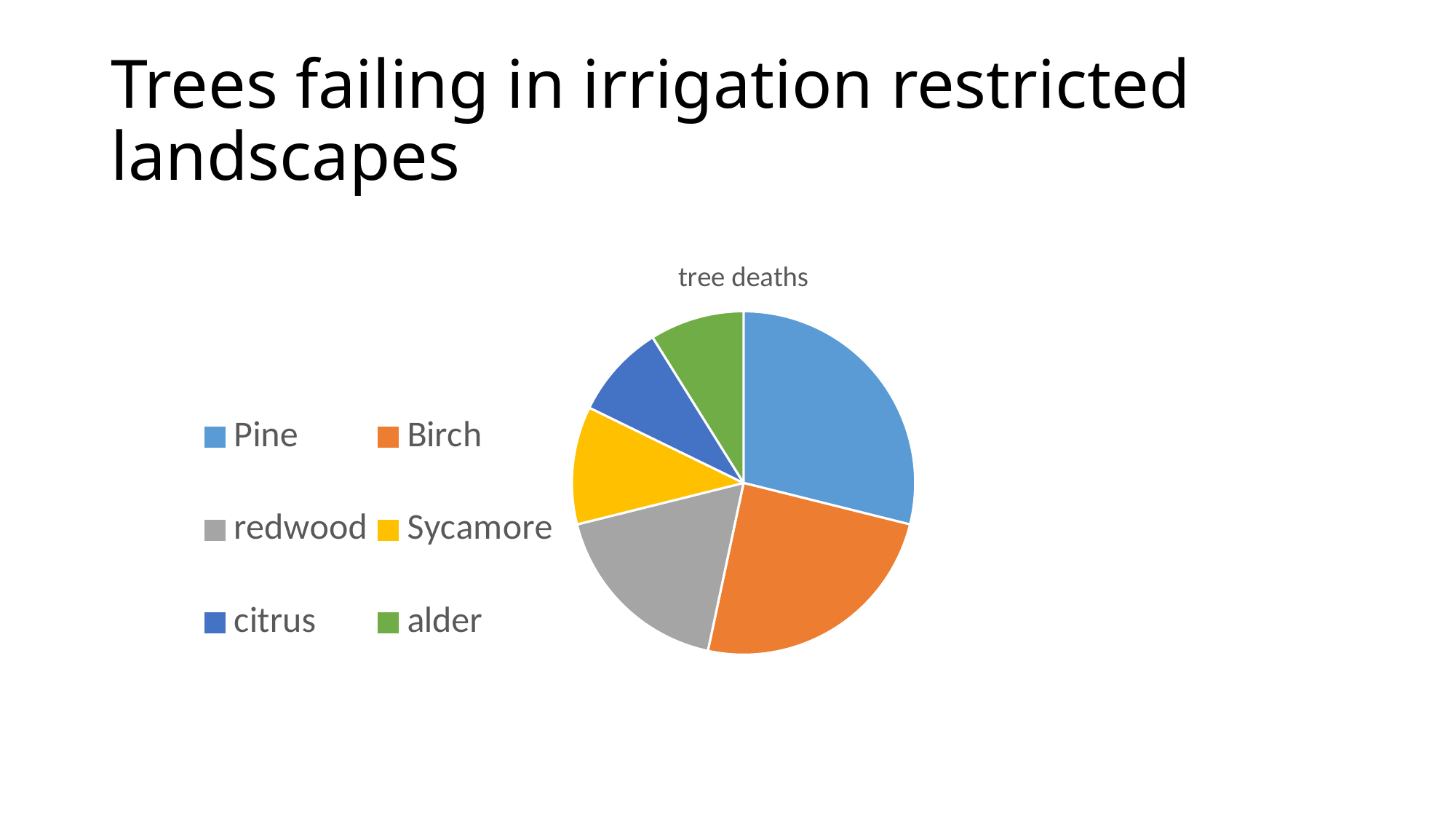
Which slice is larger, redwood or citrus? redwood Which slice is larger, Pine or redwood? Pine What is the title of the chart? tree deaths How many entries does the legend list? 6 Which slice is larger, Pine or Sycamore? Pine Which colour represents Birch in the pie chart? orange What kind of chart is shown on the slide? pie chart How many categories does the pie chart show? 6